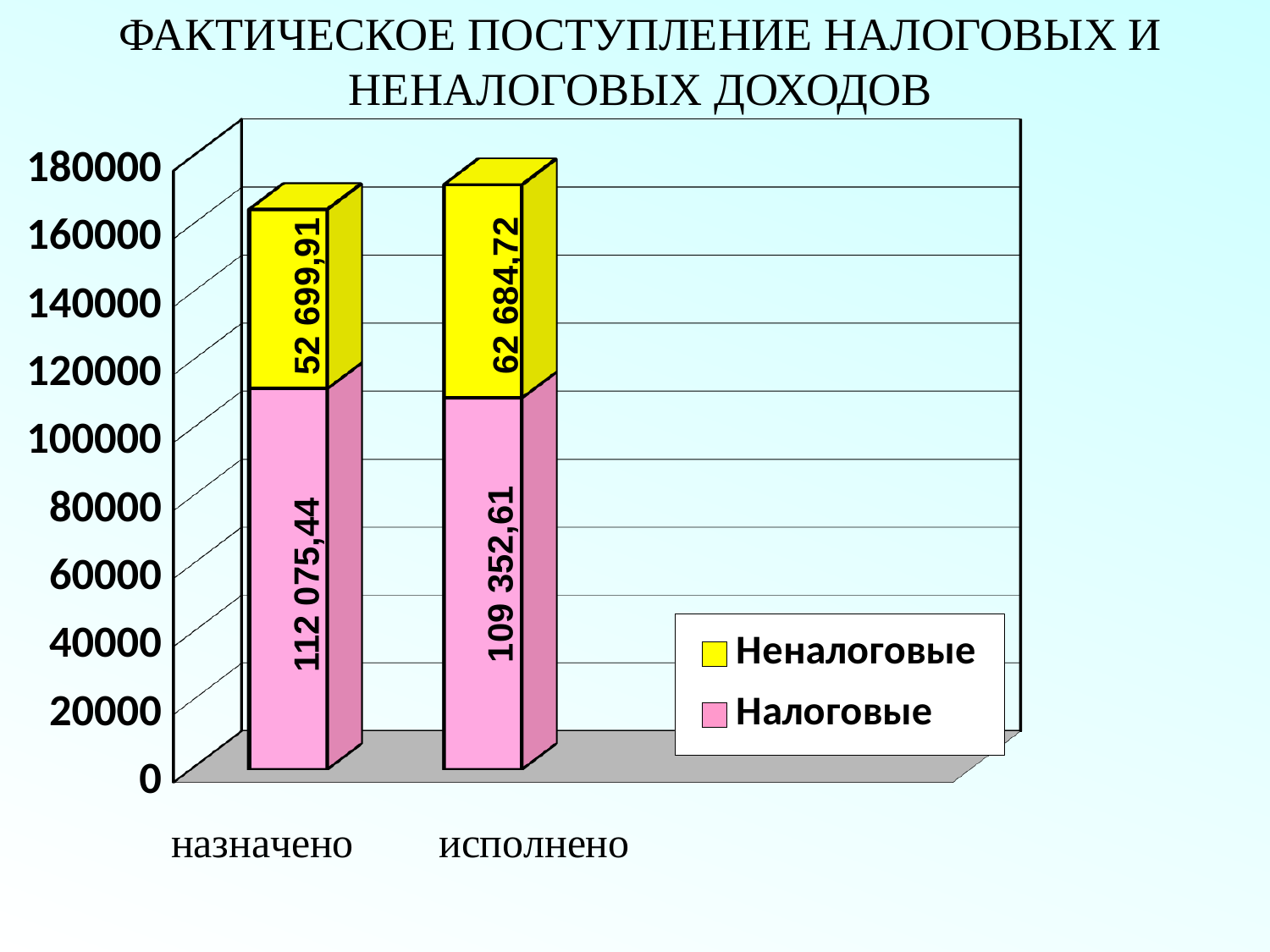
Which category has the higher value for Налоговые, назначено or исполнено? назначено What is the value of Налоговые for исполнено? 109 352,61 How many series does the legend list? 2 Which colour represents the Неналоговые series? Yellow What kind of chart is shown on the slide? Stacked bar chart What is the difference between the Неналоговые values for исполнено and назначено? 9 984,81 What is the value of Налоговые for назначено? 112 075,44 What is the total of the stacked bar for исполнено? 172 037,33 How many categories are shown on the x axis? 2 What is the value of Неналоговые for назначено? 52 699,91 What is the value of Неналоговые for исполнено? 62 684,72 Which category has the higher value for Неналоговые, назначено or исполнено? исполнено